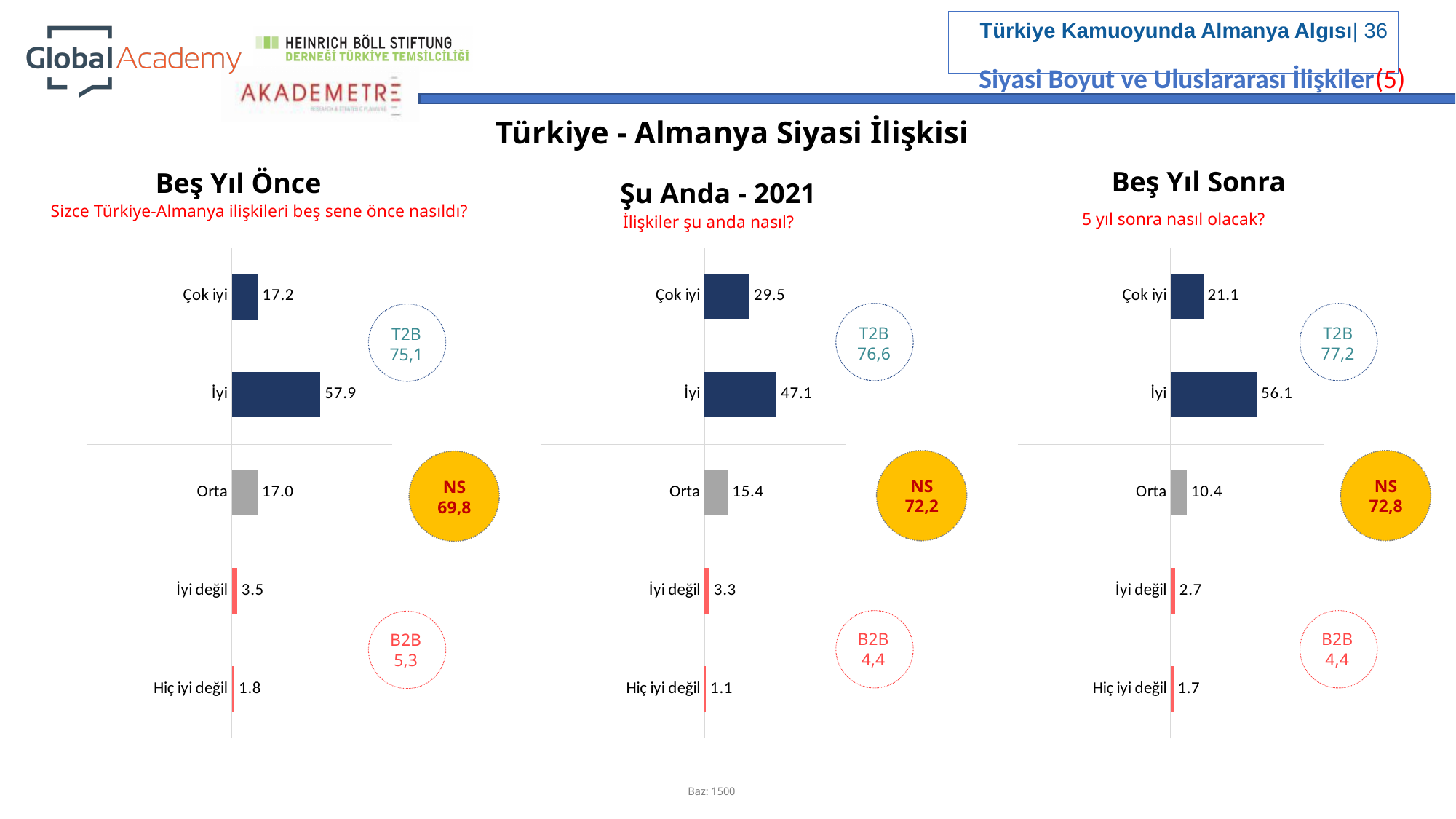
In the "Beş Yıl Sonra" chart, what is the value for "İyi değil"? 2.7 What is the T2B value shown next to the "Beş Yıl Sonra" chart? 77,2 In the "Şu Anda - 2021" chart, which category has the lowest value? Hiç iyi değil How many categories are shown in the "Beş Yıl Önce" chart? 5 What is the NS value shown next to the "Beş Yıl Önce" chart? 69,8 In the "Şu Anda - 2021" chart, what is the value for "Çok iyi"? 29.5 What type of chart is the "Şu Anda - 2021" chart? Bar chart Which is larger: the value for "Çok iyi" in the "Şu Anda - 2021" chart or in the "Beş Yıl Sonra" chart? Şu Anda - 2021 In the "Beş Yıl Önce" chart, what is the difference between the values for "İyi" and "Çok iyi"? 40.7 In the "Beş Yıl Sonra" chart, what is the value for "Orta"? 10.4 In the "Beş Yıl Önce" chart, what is the value for "İyi"? 57.9 In the "Beş Yıl Sonra" chart, which category has the highest value? İyi